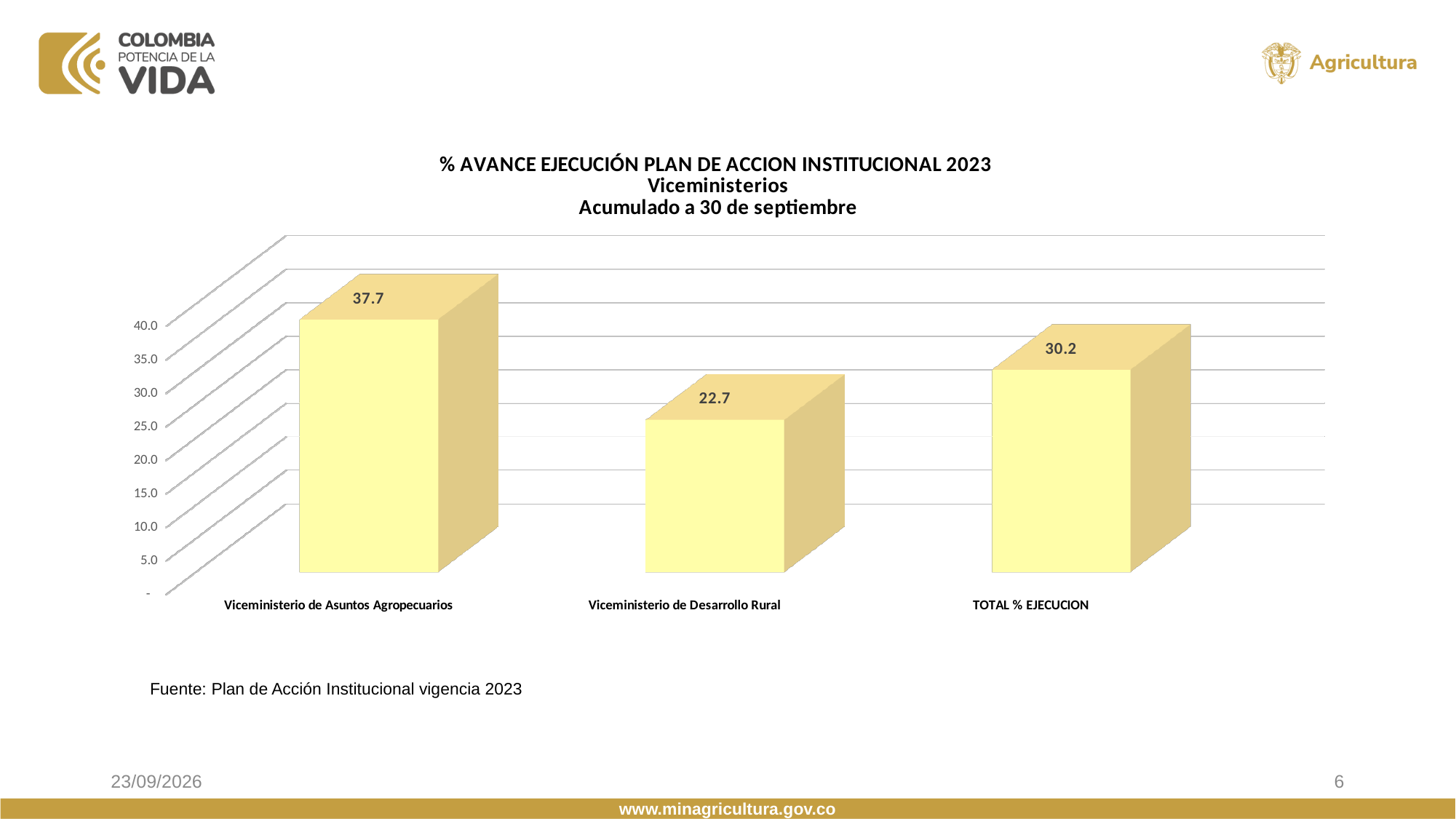
Which category has the highest value? Viceministerio de Asuntos Agropecuarios Which category has the lowest value? Viceministerio de Desarrollo Rural What is the value for Viceministerio de Desarrollo Rural? 22.7 What is the difference between the values for Viceministerio de Asuntos Agropecuarios and Viceministerio de Desarrollo Rural? 15.0 Is the value for Viceministerio de Desarrollo Rural greater or less than 25.0? less What kind of chart is shown on the slide? bar chart What is the value for Viceministerio de Asuntos Agropecuarios? 37.7 How many categories are shown on the chart? 3 What is the value for TOTAL % EJECUCION? 30.2 Which is larger, the value for Viceministerio de Desarrollo Rural or the value for TOTAL % EJECUCION? TOTAL % EJECUCION What is the difference between the values for TOTAL % EJECUCION and Viceministerio de Desarrollo Rural? 7.5 What is the title of the chart? % AVANCE EJECUCIÓN PLAN DE ACCION INSTITUCIONAL 2023 Viceministerios Acumulado a 30 de septiembre